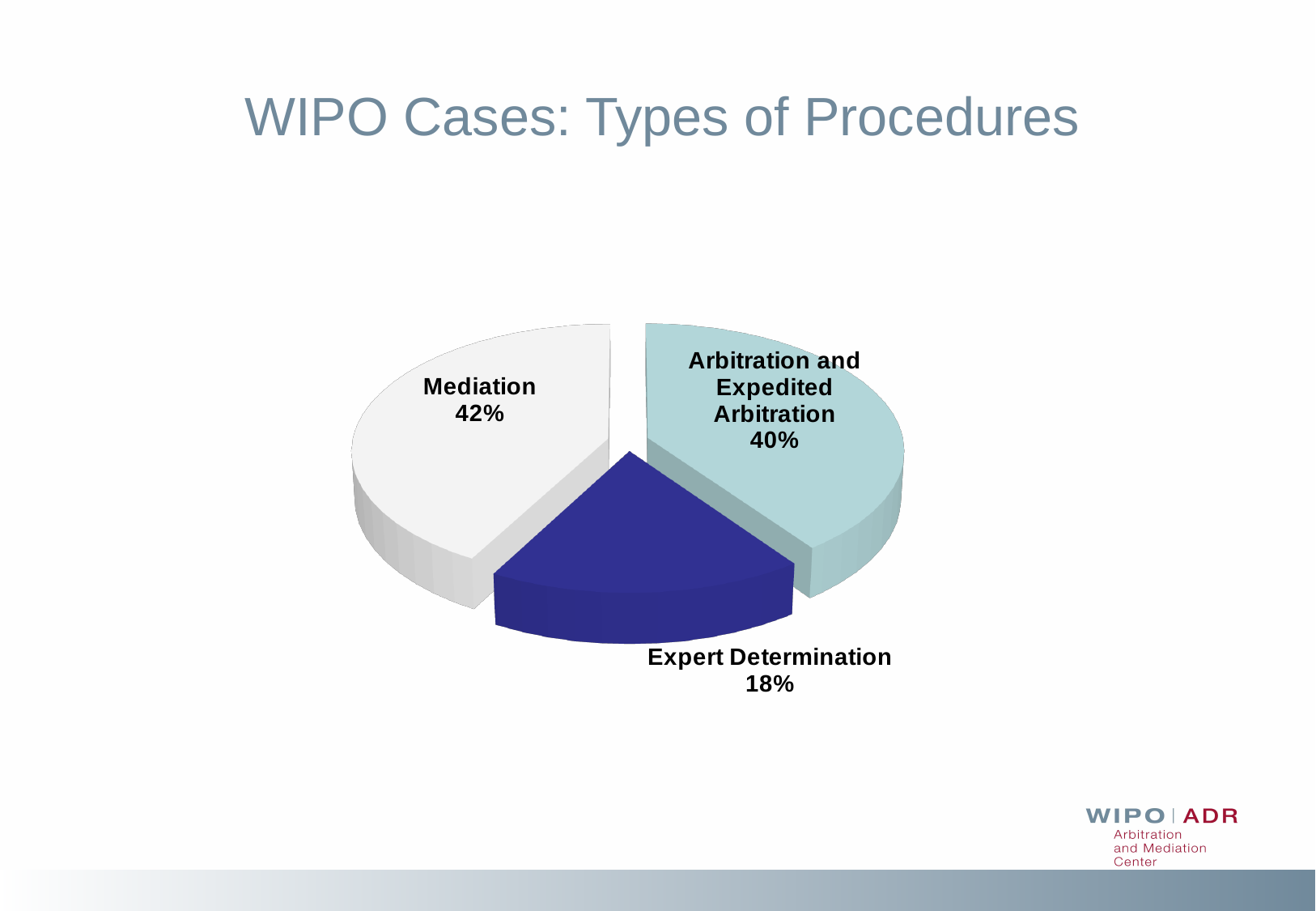
What is the title of the slide containing the pie chart? WIPO Cases: Types of Procedures What is the difference in percentage points between Mediation and Expert Determination? 24 What type of chart is shown on the slide? Pie chart What share of WIPO cases is Expert Determination? 18% What is the difference in percentage points between Mediation and Arbitration and Expedited Arbitration? 2 Which is larger: the share for Arbitration and Expedited Arbitration or the share for Expert Determination? Arbitration and Expedited Arbitration How many types of procedures are shown in the pie chart? 3 What share of WIPO cases is Mediation? 42% Which type of procedure has the largest share of WIPO cases? Mediation What share of WIPO cases is Arbitration and Expedited Arbitration? 40% What colour is the Expert Determination slice of the pie chart? Dark blue Which type of procedure has the smallest share of WIPO cases? Expert Determination